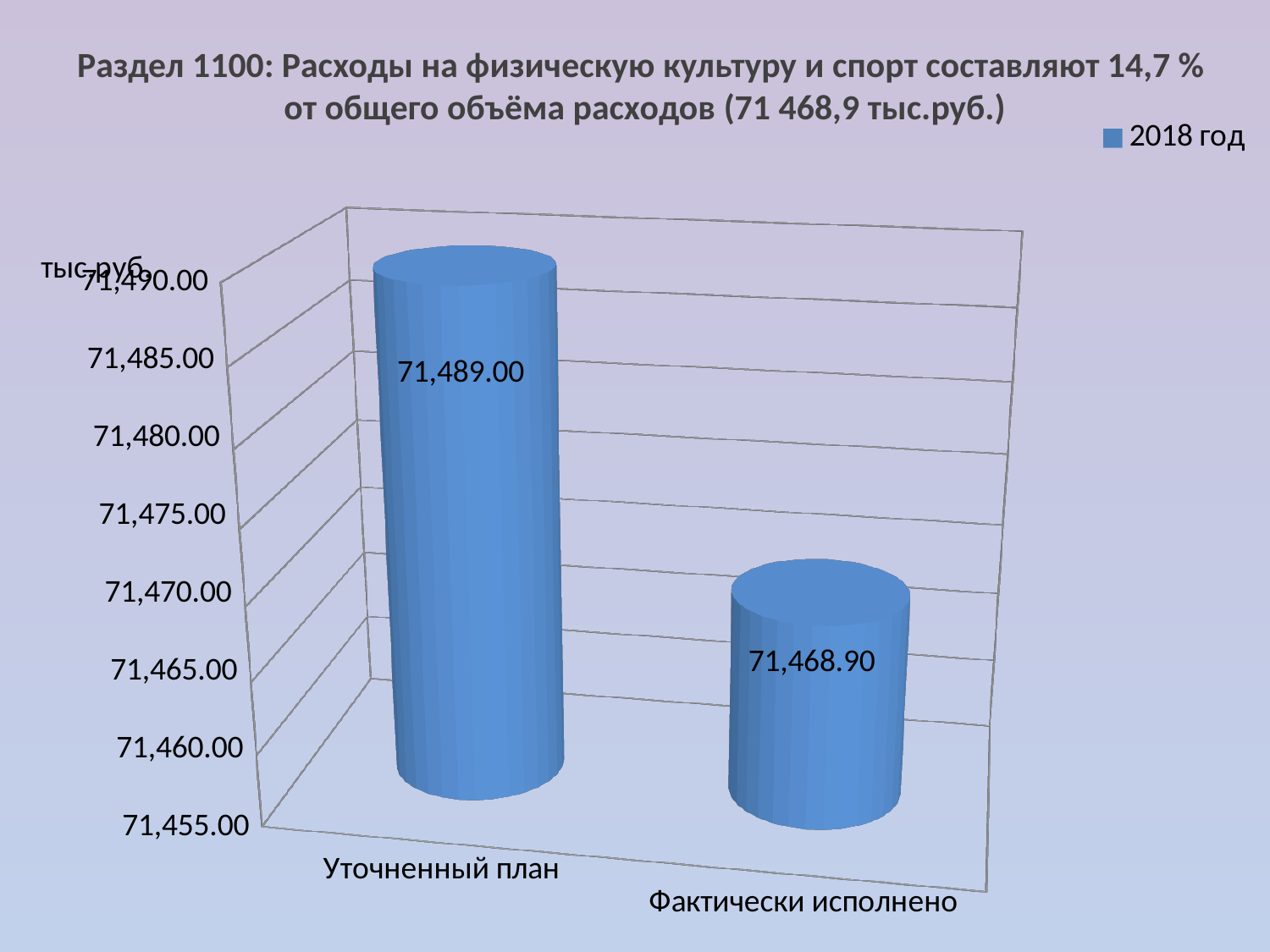
How many categories are shown on the chart? 2 Which category has the lowest value? Фактически исполнено Is the value for Уточненный план greater or less than 71,485.00? greater What is the value for Фактически исполнено? 71,468.90 What is the value for Уточненный план? 71,489.00 What series name is shown in the legend? 2018 год How many series does the legend list? 1 What is the difference between the values for Уточненный план and Фактически исполнено? 20.10 Which is larger, the value for Уточненный план or the value for Фактически исполнено? Уточненный план Is the value for Фактически исполнено greater or less than 71,470.00? less What kind of chart is shown on the slide? bar chart Which category has the highest value? Уточненный план